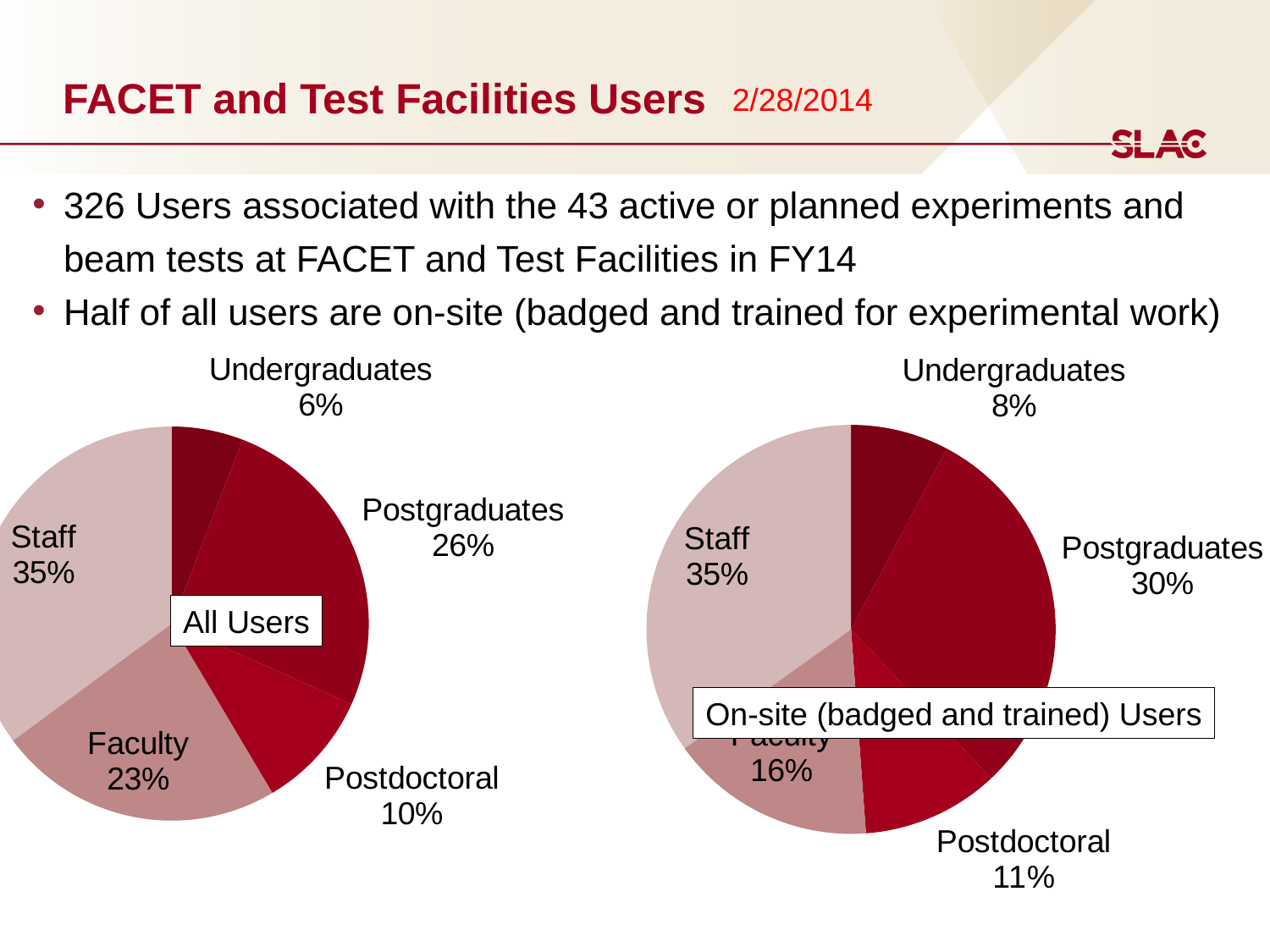
In the "All Users" pie chart, which category has the smallest share? Undergraduates In the "All Users" pie chart, which is larger: the Faculty share or the Postdoctoral share? Faculty In the "On-site (badged and trained) Users" pie chart, what share do Postgraduates have? 30% In the "All Users" pie chart, which category has the largest share? Staff In the "All Users" pie chart, what is the difference between the Staff share and the Postdoctoral share? 25% In the "On-site (badged and trained) Users" pie chart, what is the difference between the Postgraduates share and the Faculty share? 14% In the "On-site (badged and trained) Users" pie chart, which category has the smallest share? Undergraduates How many categories does the "All Users" pie chart show? 5 In the "On-site (badged and trained) Users" pie chart, what share do Undergraduates have? 8% In the "All Users" pie chart, what share do Postgraduates have? 26% What type of chart is used on the left side of the slide? Pie chart In the "All Users" pie chart, what share do Faculty have? 23%